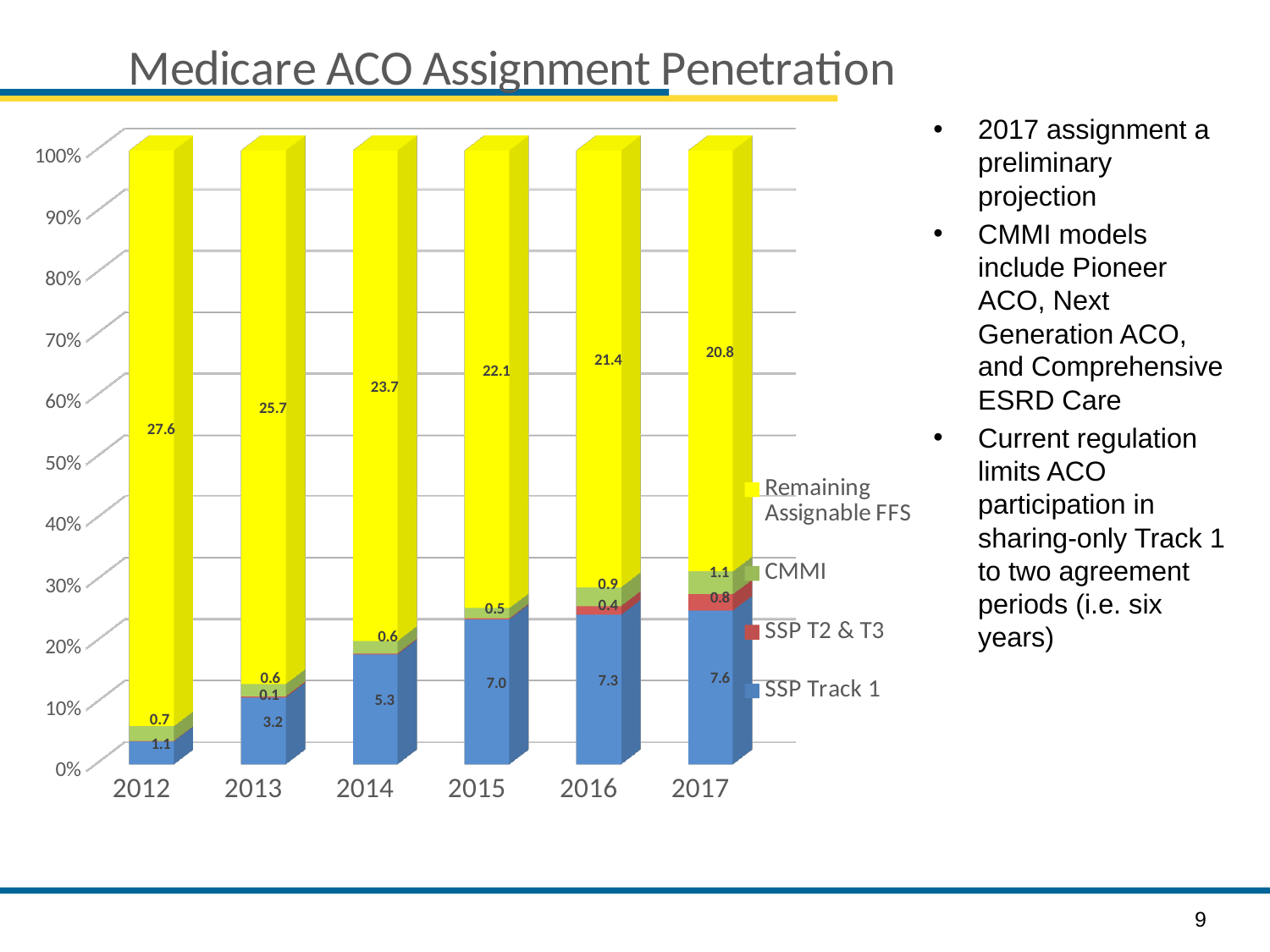
What is the SSP T2 & T3 value for 2016? 0.4 What is the SSP Track 1 value for 2014? 5.3 What is the CMMI value for 2017? 1.1 How many years are shown on the x axis? 6 How many series does the legend list? 4 What is the difference between the SSP Track 1 values for 2017 and 2012? 6.5 Does the Remaining Assignable FFS value rise or fall from 2012 to 2017? Fall Which is larger, the CMMI value for 2016 or the CMMI value for 2015? 2016 What type of chart is shown on the slide? Stacked bar chart What is the Remaining Assignable FFS value for 2012? 27.6 Which year has the highest SSP Track 1 value? 2017 Which year has the lowest Remaining Assignable FFS value? 2017